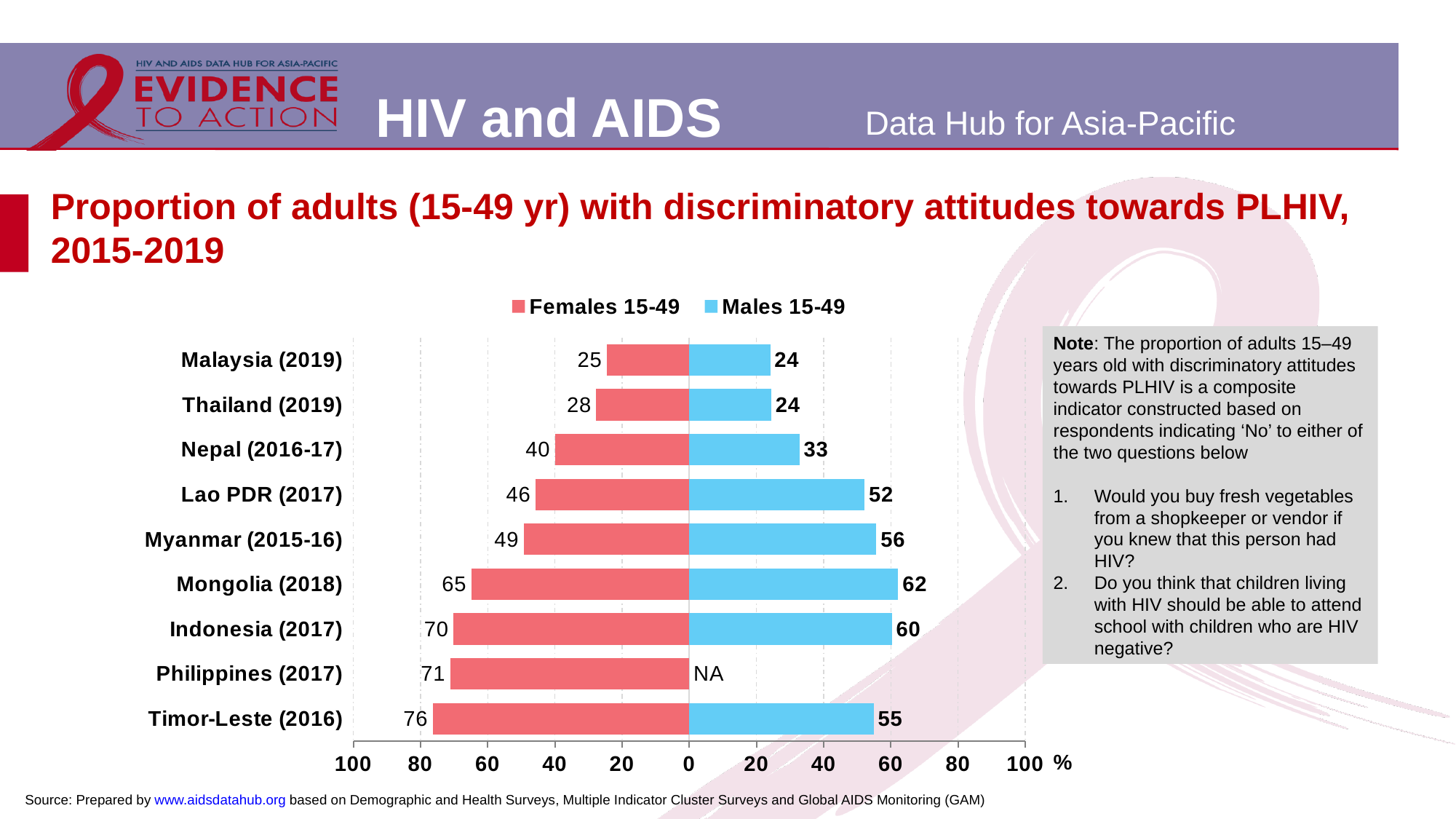
Which is larger for Lao PDR (2017): the Females 15-49 value or the Males 15-49 value? Males 15-49 How many countries are shown on the chart? 9 What is the value for Males 15-49 in the Philippines (2017)? NA Which colour represents Males 15-49 in the chart? Blue What kind of chart is shown on the slide? Bar chart How many series does the legend list? 2 What is the value for Males 15-49 in Nepal (2016-17)? 33 What is the value for Females 15-49 in Timor-Leste (2016)? 76 Which country has the highest value for Males 15-49? Mongolia (2018) What is the difference between the Females 15-49 and Males 15-49 values for Indonesia (2017)? 10 Which country has the highest value for Females 15-49? Timor-Leste (2016) Which country has the lowest value for Females 15-49? Malaysia (2019)